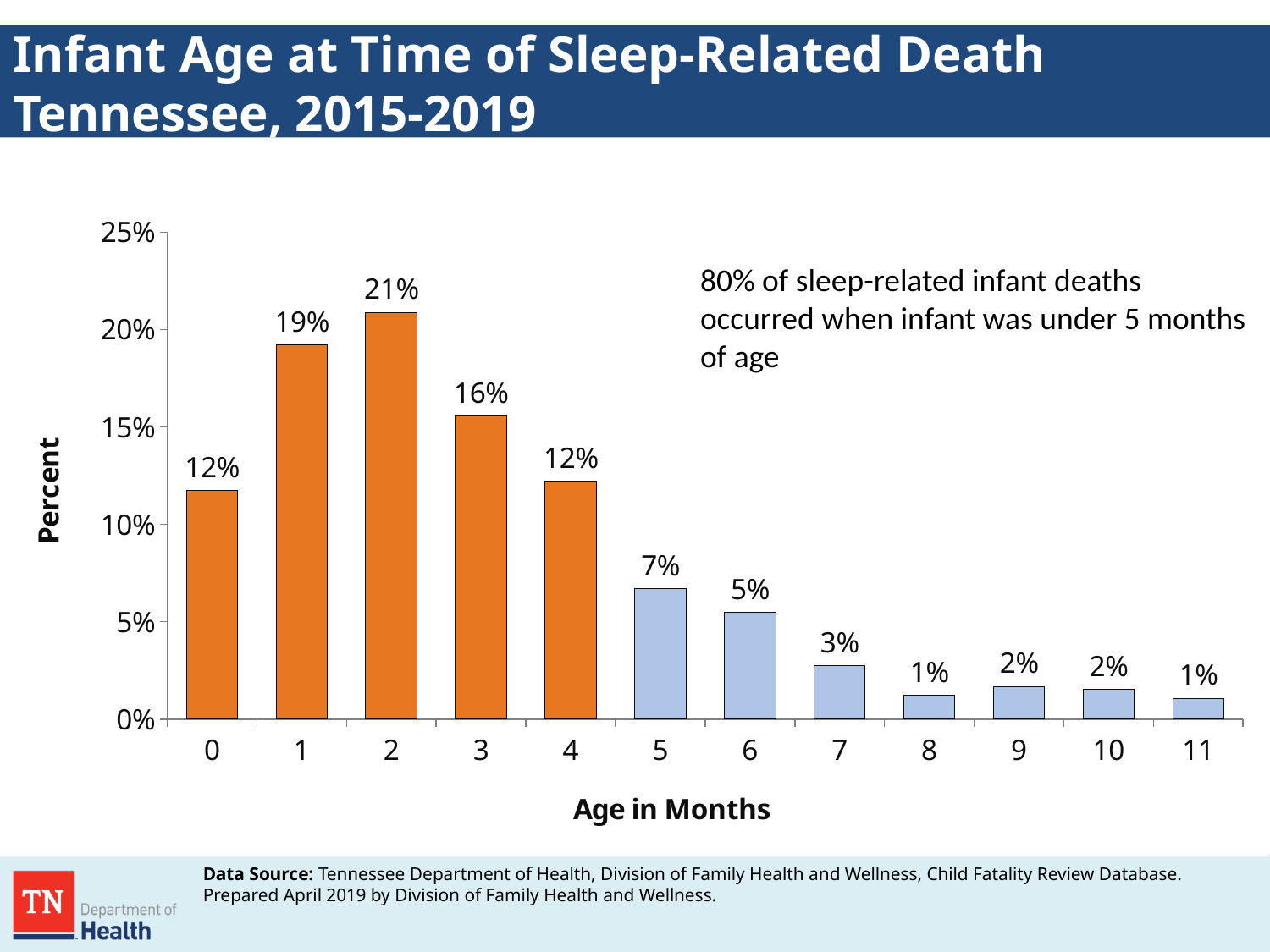
What is the label of the x axis? Age in Months What is the difference between the value for age 2 months and the value for age 4 months? 9% What percent is shown for age 5 months? 7% Which has a larger value, age 6 months or age 7 months? 6 months What is the difference in percent between age 1 month and age 3 months? 3% What percent of sleep-related infant deaths occurred at age 2 months? 21% What kind of chart is shown on the slide? Bar chart Do the values rise or fall along the x axis from age 2 months to age 11 months? Fall Is the value for age 3 months greater or less than 15%? greater Which age in months has the highest percent of sleep-related deaths? 2 What is the value shown for age 0 months? 12% How many age categories are shown on the x axis? 12